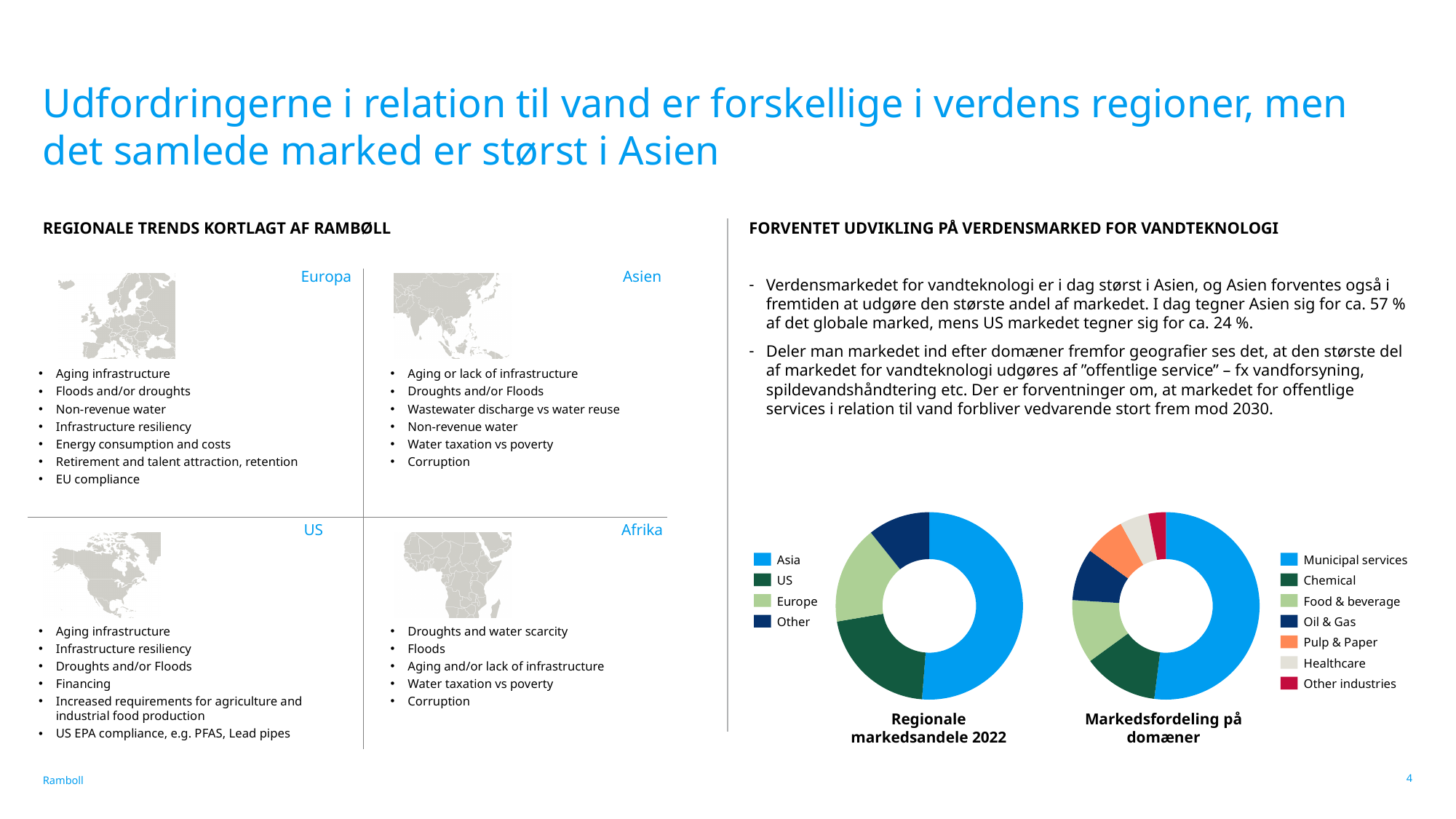
In the "Markedsfordeling på domæner" chart, what colour represents Pulp & Paper? Orange How many categories does the "Regionale markedsandele 2022" chart show? 4 In the "Markedsfordeling på domæner" chart, which domain has the largest share? Municipal services In the "Regionale markedsandele 2022" chart, which category has the smallest share? Other What is the title of the chart on the right side of the slide? Markedsfordeling på domæner How many categories does the "Markedsfordeling på domæner" chart show? 7 In the "Markedsfordeling på domæner" chart, which domain has the smallest share? Other industries In the "Markedsfordeling på domæner" chart, which is larger, the share for Chemical or the share for Food & beverage? Chemical In the "Regionale markedsandele 2022" chart, which is larger, the share for US or the share for Europe? US In the "Regionale markedsandele 2022" chart, which region has the largest share? Asia In the "Regionale markedsandele 2022" chart, which is larger, the share for Asia or the share for US? Asia What type of chart is the "Regionale markedsandele 2022" chart? Pie (donut) chart